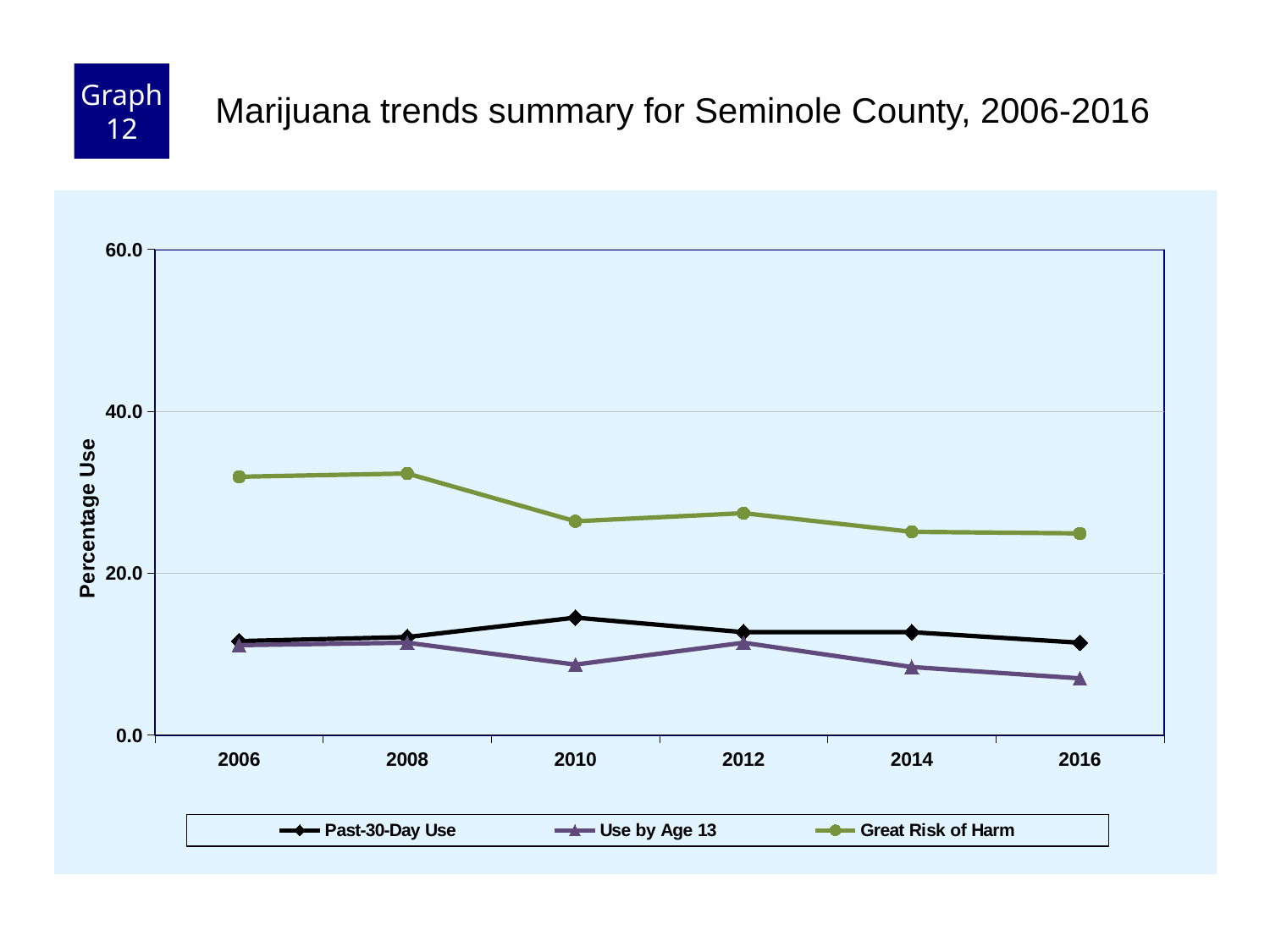
How many series does the legend list? 3 In which year is Use by Age 13 at its lowest? 2016 Is the value for Great Risk of Harm in 2006 greater or less than 20.0? greater Is the value for Great Risk of Harm in 2008 greater or less than 40.0? less Does Great Risk of Harm rise or fall overall from 2006 to 2016? Fall How many years are plotted along the x axis? 6 What is the label on the y axis? Percentage Use In which year is Past-30-Day Use at its highest? 2010 Which series has the highest values across all years? Great Risk of Harm In 2010, which is larger: Past-30-Day Use or Use by Age 13? Past-30-Day Use What kind of chart is shown on the slide? Line chart Is the value for Past-30-Day Use in 2010 greater or less than 20.0? less